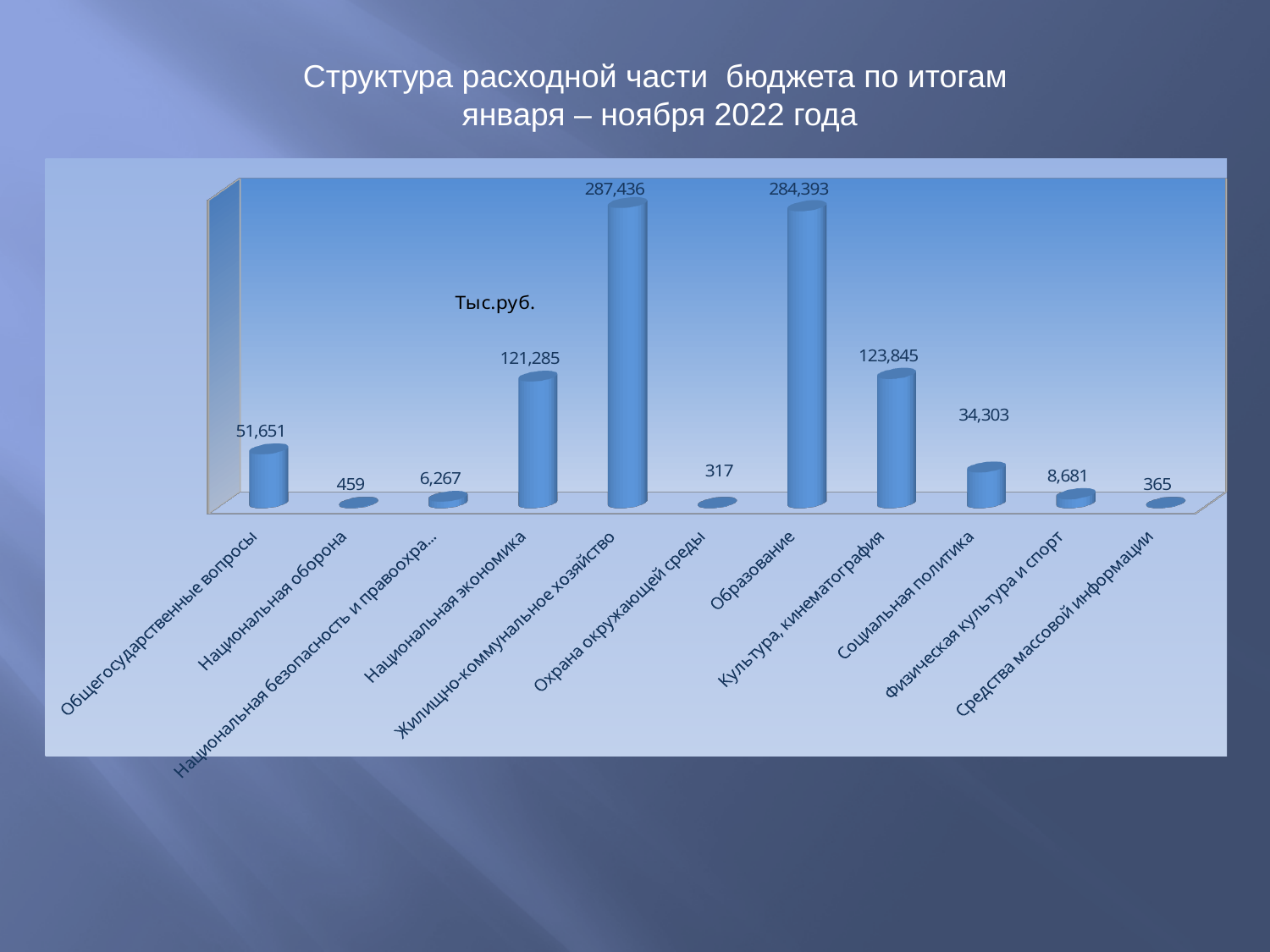
Which category has the lowest value? Охрана окружающей среды What kind of chart is shown on the slide? bar chart What is the value for Социальная политика? 34,303 What is the difference between Культура, кинематография and Национальная экономика? 2,560 What is the difference between Жилищно-коммунальное хозяйство and Образование? 3,043 What unit label is printed inside the chart area? Тыс.руб. What is the value for Национальная экономика? 121,285 Which category has the highest value? Жилищно-коммунальное хозяйство What is the value for Средства массовой информации? 365 What is the value for Образование? 284,393 How many categories are shown in the chart? 11 Which is larger: Общегосударственные вопросы or Социальная политика? Общегосударственные вопросы